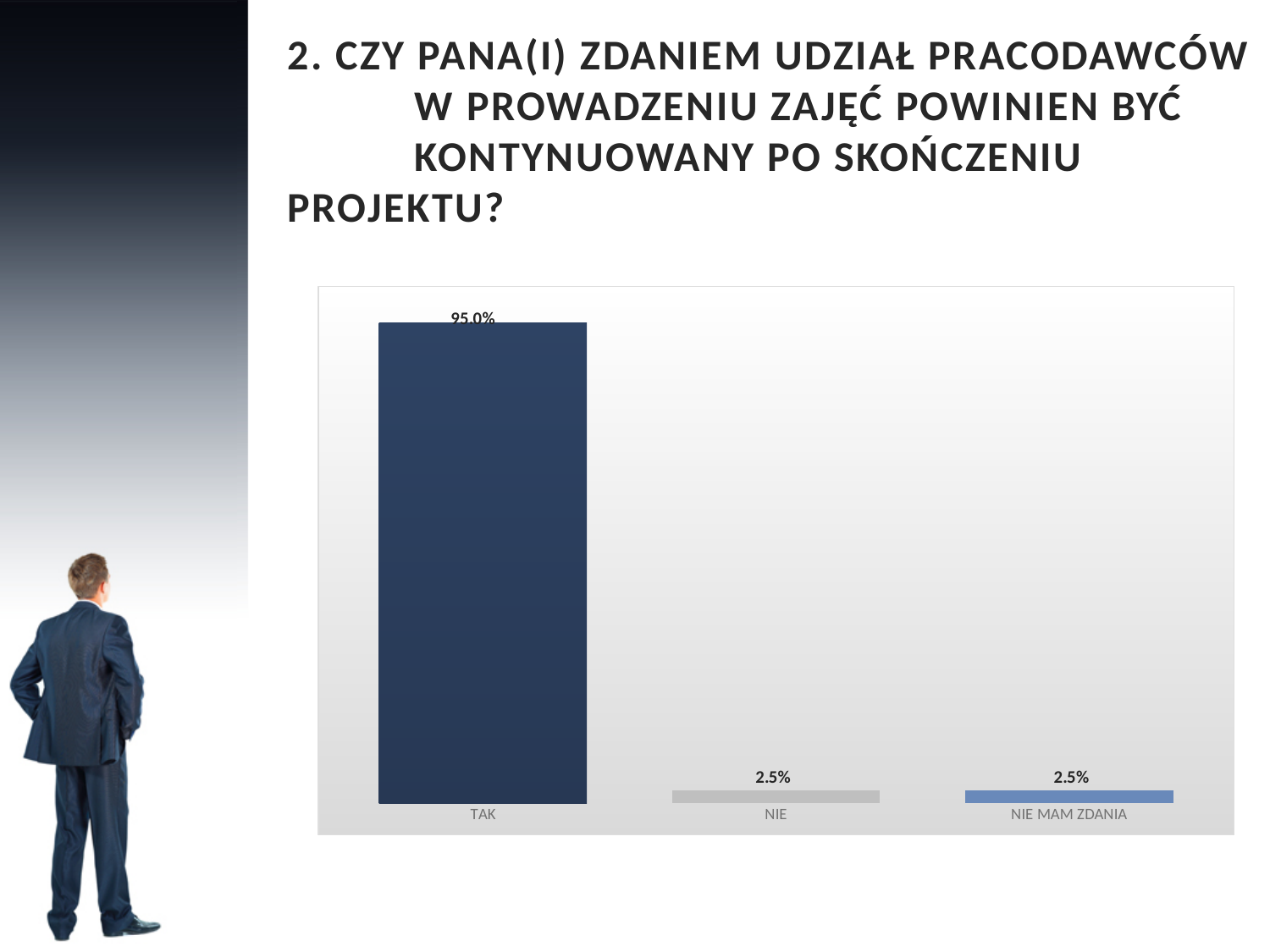
Which category has the highest value? TAK Which is larger, the value for TAK or the value for NIE MAM ZDANIA? TAK How many categories are shown on the x axis? 3 What colour is the bar for TAK? dark blue What is the difference between the values for TAK and NIE? 92.5% What is the value for NIE? 2.5% What is the value for TAK? 95.0% What is the total of the values for NIE and NIE MAM ZDANIA? 5.0% What kind of chart is shown on the slide? bar chart What is the label of the third category on the x axis? NIE MAM ZDANIA What is the value for NIE MAM ZDANIA? 2.5%